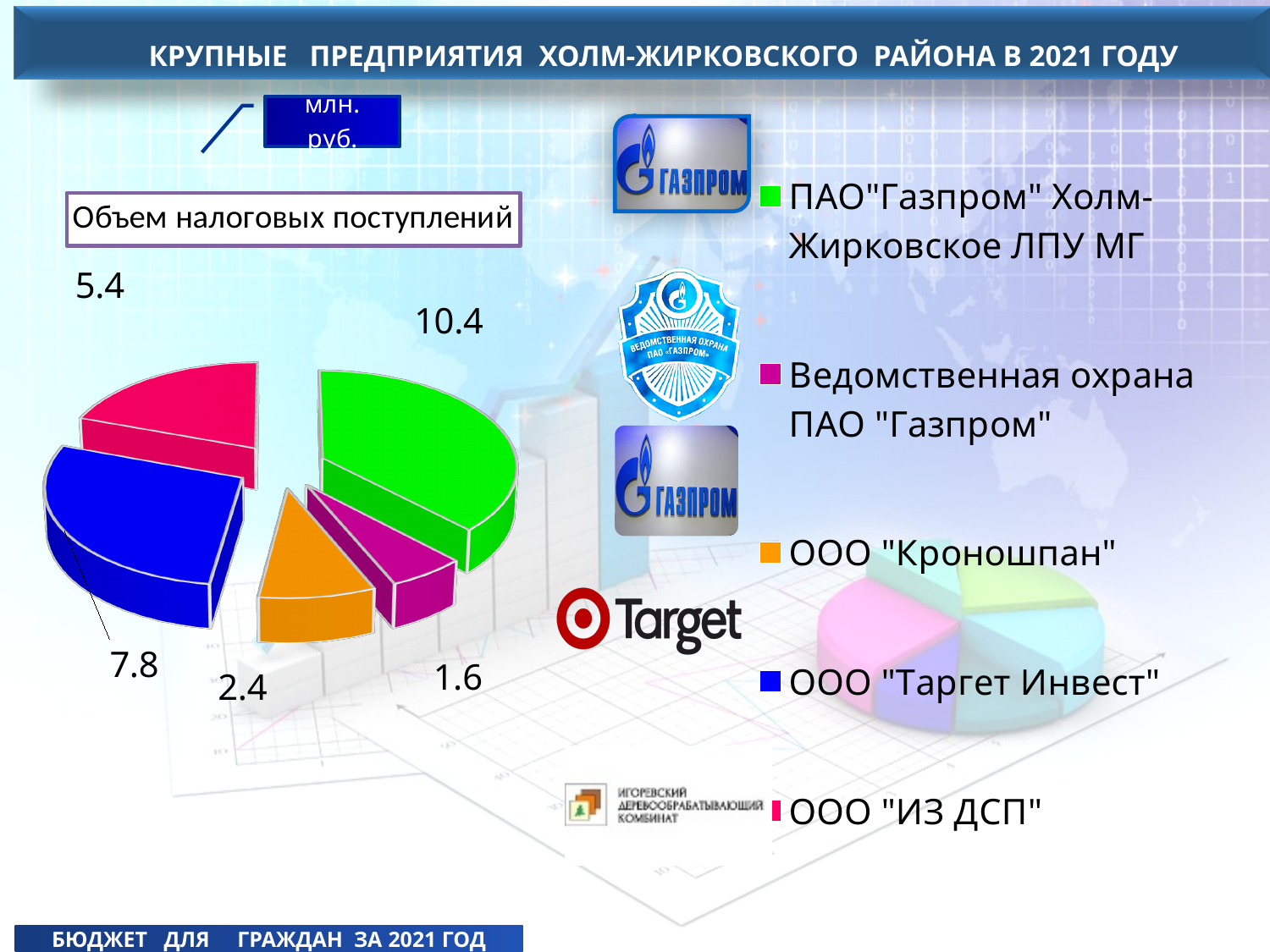
In what units are the values on the chart given? млн. руб. What is the value for ООО "ИЗ ДСП"? 5.4 What is the value for ООО "Кроношпан"? 2.4 Which enterprise has the smallest share of tax revenue? Ведомственная охрана ПАО "Газпром" How many enterprises are shown in the pie chart? 5 Which enterprise has the largest share of tax revenue? ПАО "Газпром" Холм-Жирковское ЛПУ МГ What is the value for ООО "Таргет Инвест"? 7.8 What is the value for Ведомственная охрана ПАО "Газпром"? 1.6 What is the value for ПАО "Газпром" Холм-Жирковское ЛПУ МГ? 10.4 What is the title of the chart? Объем налоговых поступлений What is the difference between the values for ПАО "Газпром" Холм-Жирковское ЛПУ МГ and ООО "Таргет Инвест"? 2.6 What type of chart is shown on the slide? pie chart